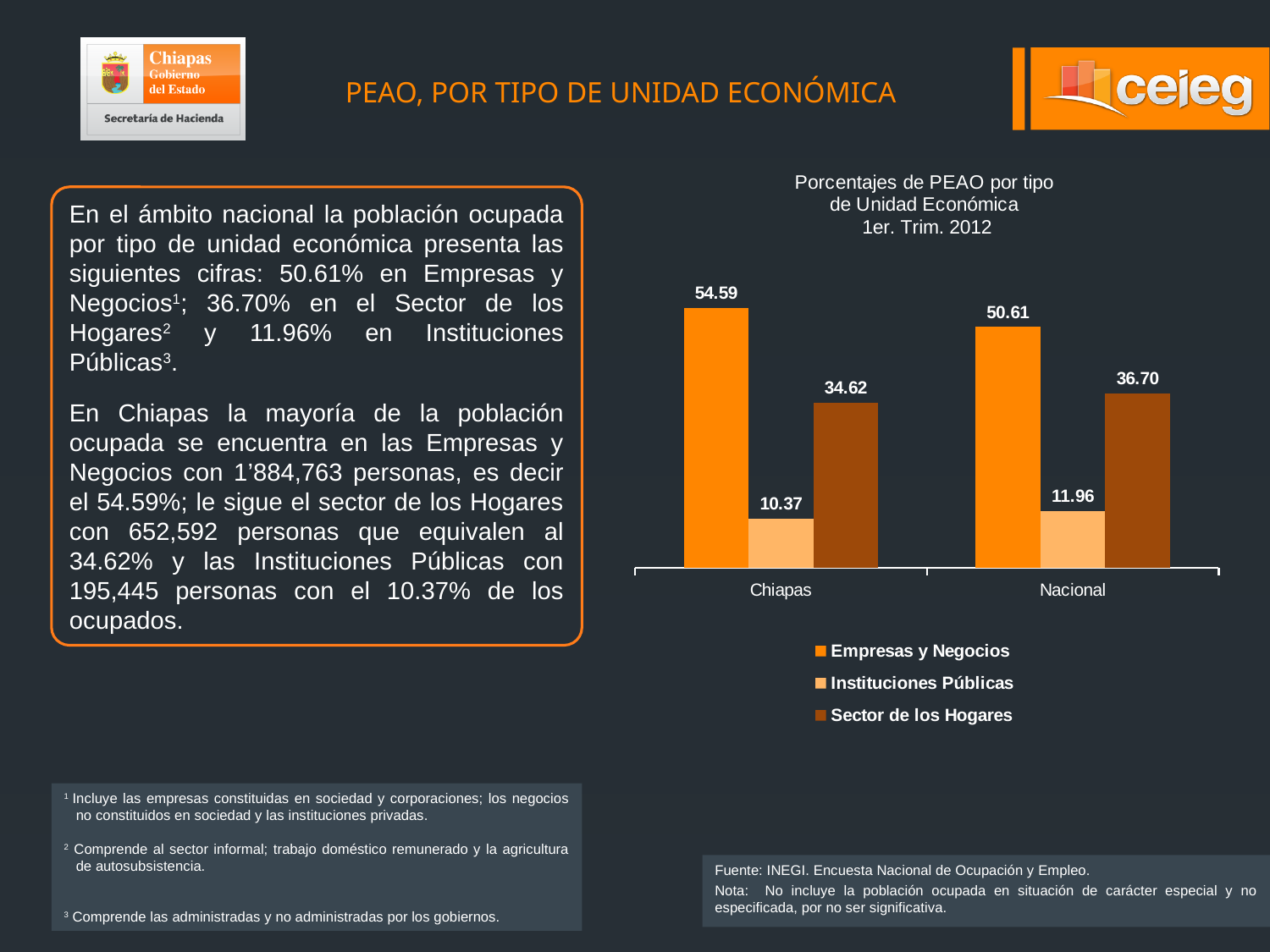
What kind of chart is shown? Bar chart Which series has the highest value in Nacional? Empresas y Negocios What is the value for Empresas y Negocios in Chiapas? 54.59 What is the difference between Empresas y Negocios in Chiapas and in Nacional? 3.98 What is the value for Sector de los Hogares in Chiapas? 34.62 How many series does the legend list? 3 What is the title of the chart? Porcentajes de PEAO por tipo de Unidad Económica 1er. Trim. 2012 What is the difference between Sector de los Hogares and Instituciones Públicas in Nacional? 24.74 Which is larger: Sector de los Hogares in Chiapas or in Nacional? Nacional Which series has the lowest value in Chiapas? Instituciones Públicas How many categories are shown on the x axis? 2 What is the value for Instituciones Públicas in Nacional? 11.96